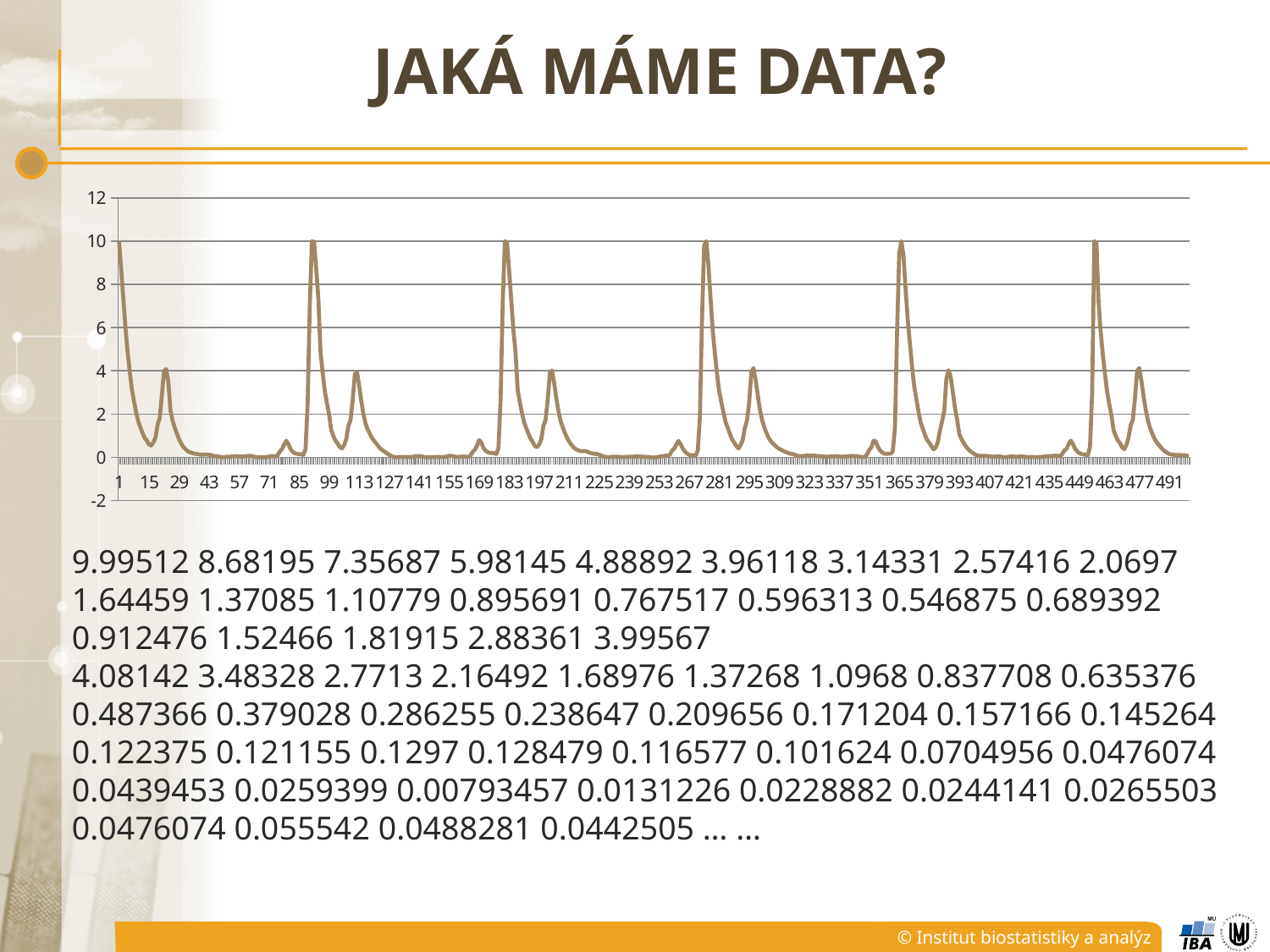
Is the value of the series at x = 1 greater or less than 8? greater What is the lowest tick value shown on the y axis of the chart? -2 Does the series show a steady upward trend, a steady downward trend, or a repeating pattern along the x axis? repeating pattern Is the value of the smaller peak near x = 29 greater or less than 2? greater Which is larger: the value of the series at x = 1 or the value at x = 57? x = 1 What is the highest tick value shown on the y axis of the chart? 12 Is the value of the smaller peak near x = 29 greater or less than 6? less How many tall peaks reaching about 10 does the series show across the chart? 6 What is the first label shown on the x axis of the chart? 1 What kind of chart is shown on the slide? line chart How many lines (series) are plotted in the chart? 1